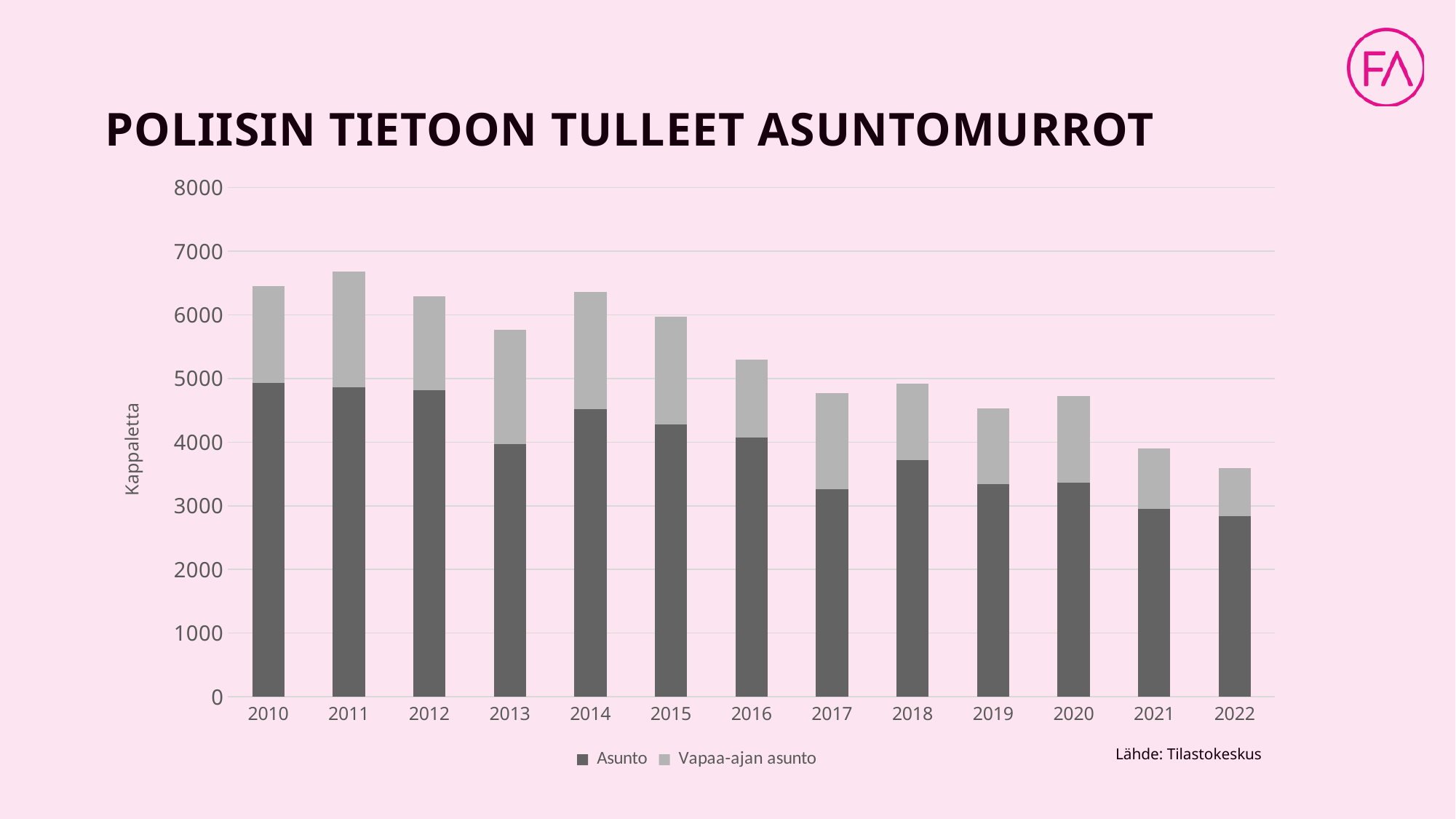
What kind of chart is shown on the slide? Stacked bar chart How many series does the legend list? 2 Is the Asunto value for 2010 greater or less than 4000? greater How many years are shown on the x axis? 13 Do the total values generally rise or fall from 2010 to 2022? Fall Is the total stacked bar for 2022 greater or less than 4000? less Which year has the lowest value for Asunto? 2022 Which year has the highest total stacked bar? 2011 Which year has the larger Asunto value, 2017 or 2018? 2018 Is the total stacked bar for 2011 greater or less than 6000? greater Which year has the lowest total stacked bar? 2022